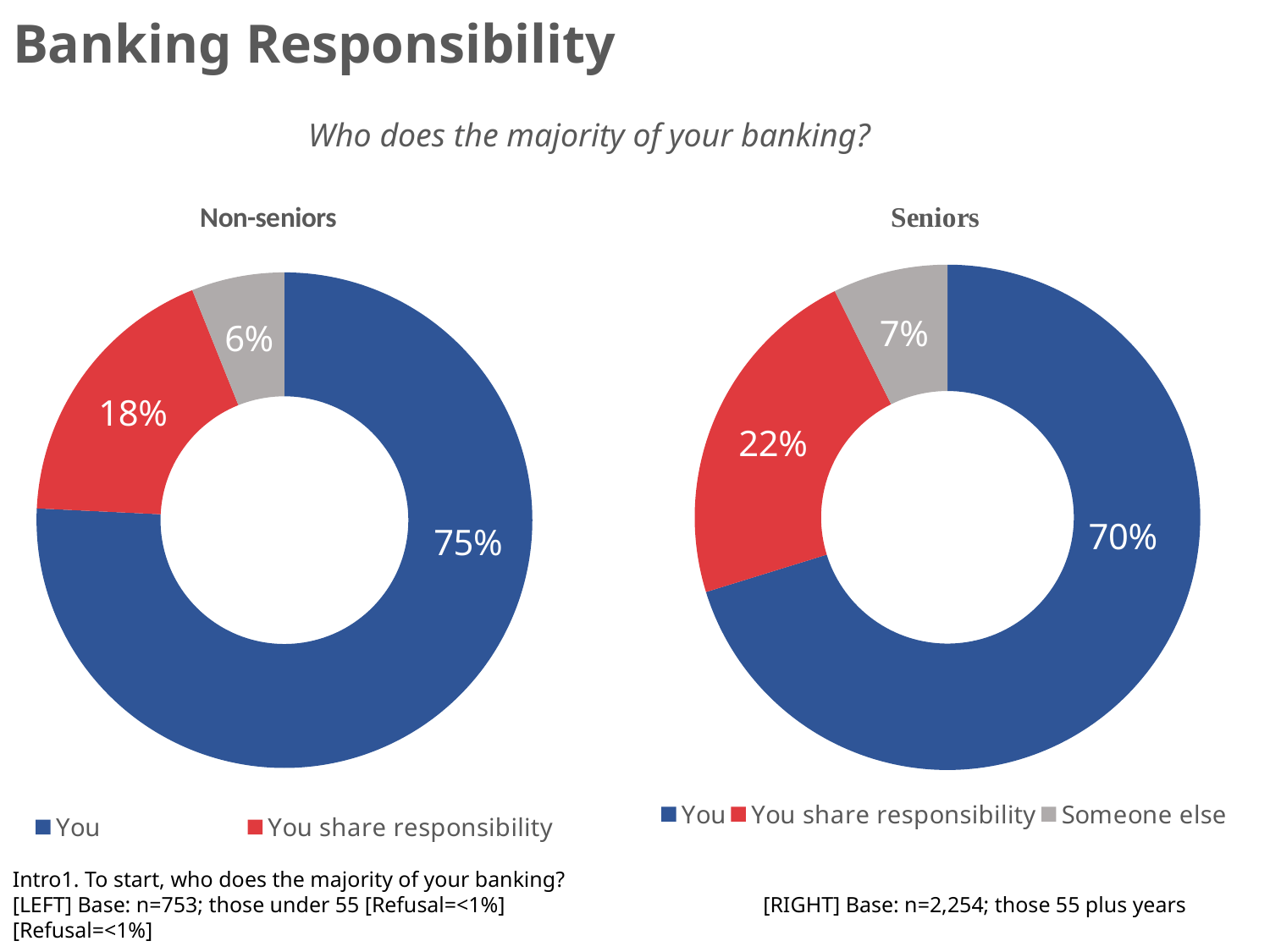
In the Non-seniors chart, what percentage answered "You"? 75% How many entries does the legend under the Seniors chart list? 3 In the Seniors chart, what percentage answered "You"? 70% How many slices does the Seniors chart have? 3 In the Seniors chart, what percentage answered "You share responsibility"? 22% In the Non-seniors chart, which category has the largest share? You What colour represents "You share responsibility" in both charts? Red Which group has a larger "You share responsibility" share, Non-seniors or Seniors? Seniors In the Seniors chart, which category has the smallest share? Someone else What type of chart is used for the Non-seniors data? Doughnut (pie) chart In the Non-seniors chart, what percentage is shown for the grey "Someone else" slice? 6% What is the difference between the "You" share for Non-seniors and the "You" share for Seniors? 5 percentage points